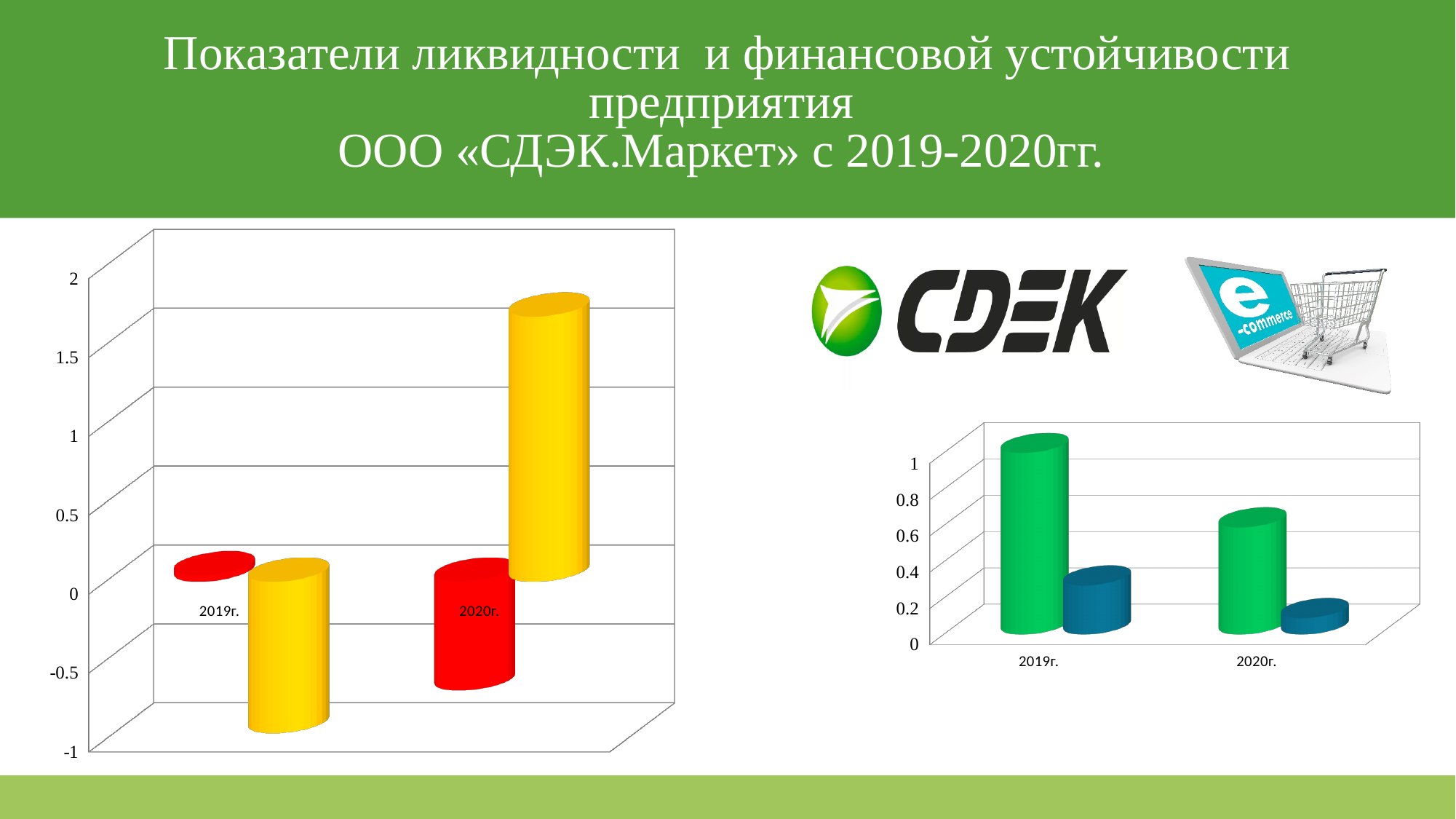
In the right chart, do the green bars rise or fall from 2019г. to 2020г.? fall What kind of chart is the chart on the left of the slide? bar chart In the left chart, is the value of the red bar for 2020г. greater or less than 0? less In the left chart, is the value of the yellow bar for 2019г. greater or less than 0? less In the left chart, how many categories are shown on the x axis? 2 In the right chart, which year has the larger green bar, 2019г. or 2020г.? 2019г. In the right chart, is the value of the blue bar for 2020г. greater or less than 0.4? less In the left chart, which year has the larger yellow bar, 2019г. or 2020г.? 2020г. What kind of chart is the chart on the right of the slide? bar chart In the right chart, how many categories are shown on the x axis? 2